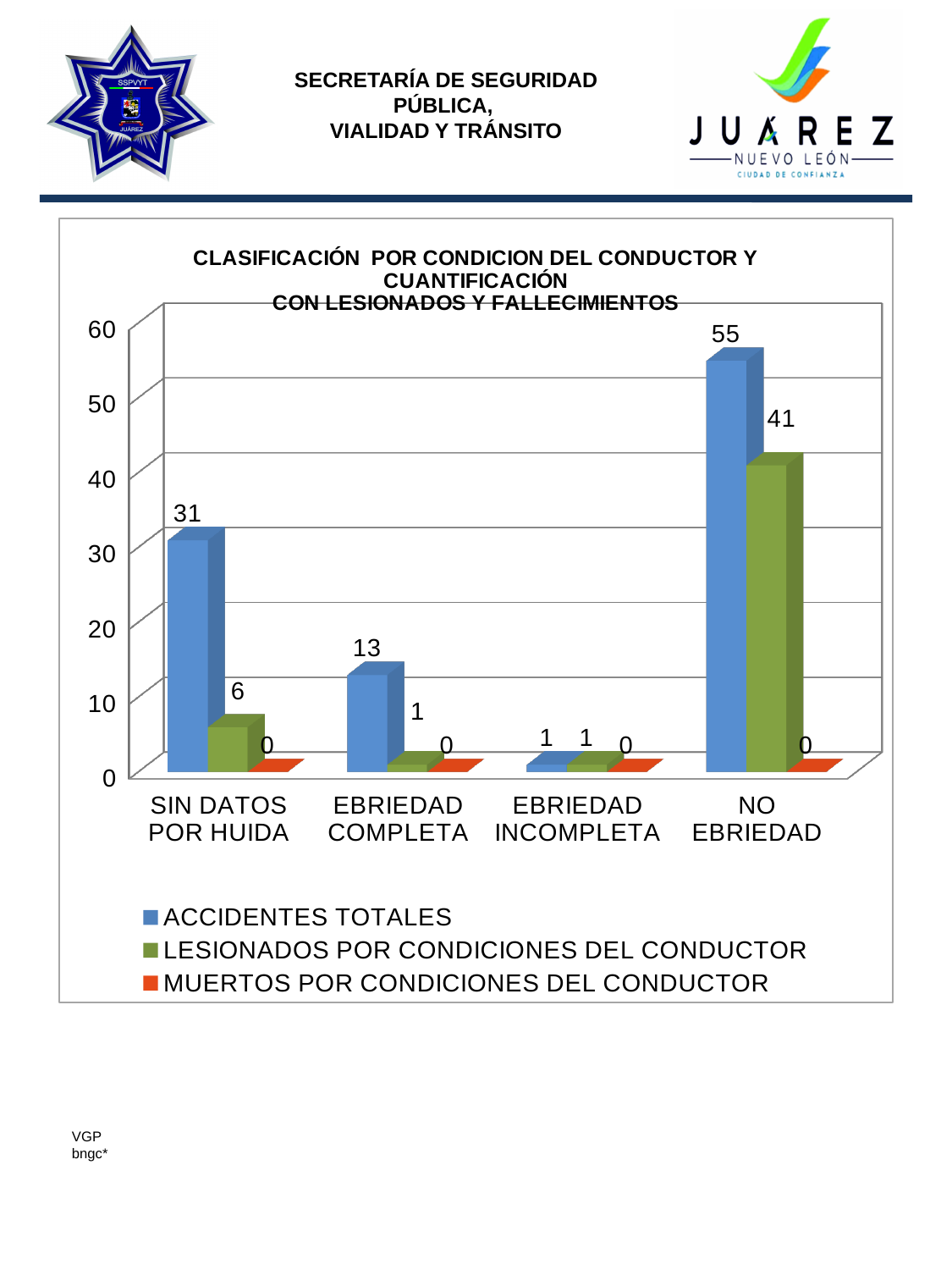
What is the value of MUERTOS POR CONDICIONES DEL CONDUCTOR for EBRIEDAD COMPLETA? 0 What kind of chart is shown on the slide? Bar chart Which colour represents MUERTOS POR CONDICIONES DEL CONDUCTOR in the legend? Orange What is the value of ACCIDENTES TOTALES for NO EBRIEDAD? 55 Which category has the lowest value for ACCIDENTES TOTALES? EBRIEDAD INCOMPLETA What is the value of ACCIDENTES TOTALES for EBRIEDAD COMPLETA? 13 Which category has the highest value for ACCIDENTES TOTALES? NO EBRIEDAD Which is larger: ACCIDENTES TOTALES for SIN DATOS POR HUIDA or ACCIDENTES TOTALES for EBRIEDAD COMPLETA? SIN DATOS POR HUIDA What is the difference between ACCIDENTES TOTALES and LESIONADOS POR CONDICIONES DEL CONDUCTOR for NO EBRIEDAD? 14 How many categories are shown on the x axis? 4 How many series does the legend list? 3 What is the value of LESIONADOS POR CONDICIONES DEL CONDUCTOR for SIN DATOS POR HUIDA? 6